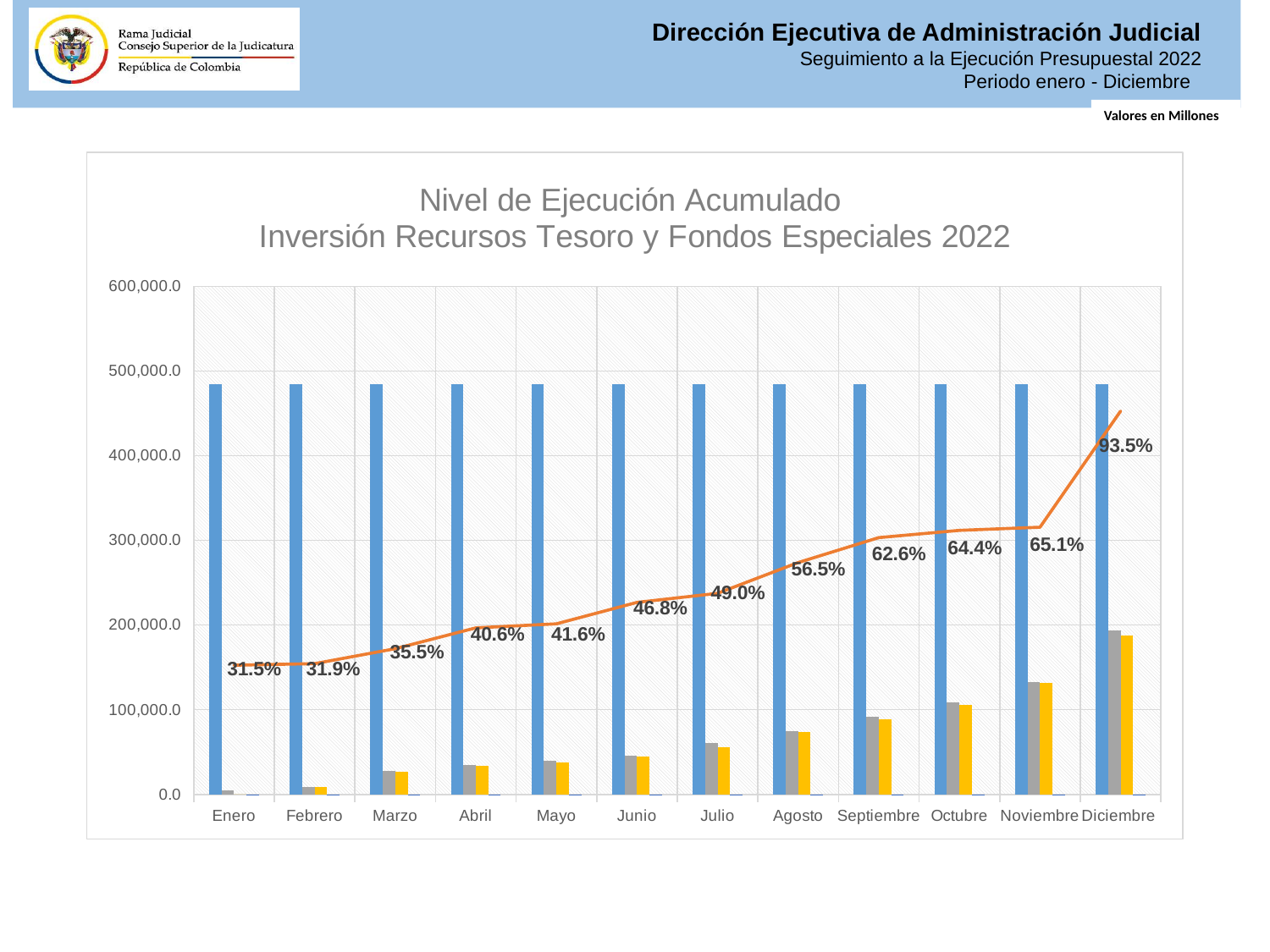
Which month has the lowest percentage label on the line? Enero Which is larger, the percentage label for Septiembre or for Octubre? Octubre How many months are shown on the x axis? 12 What percentage is labelled for Mayo on the line? 41.6% What is the difference in percentage points between the Diciembre label (93.5%) and the Noviembre label (65.1%)? 28.4 What percentage is labelled for Agosto on the line? 56.5% Do the percentage labels on the line rise or fall from Enero to Diciembre? rise Which month has the highest percentage label on the line? Diciembre Is the value of the yellow bar for Diciembre greater or less than 100,000.0? greater Is the value of the blue bar for Enero greater or less than 500,000.0? less What percentage is labelled for Diciembre on the line? 93.5% What percentage is labelled for Enero on the line? 31.5%